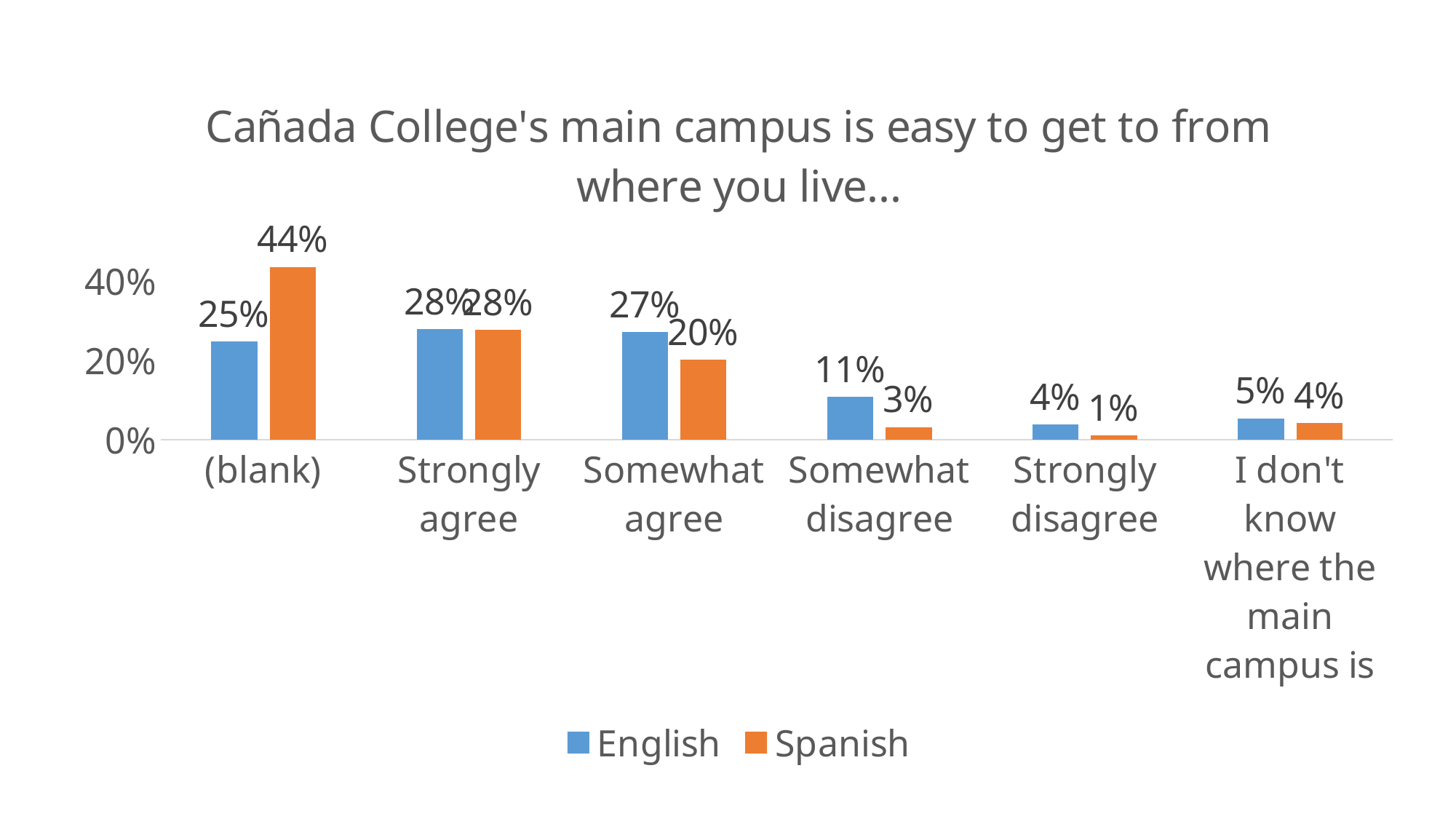
Which category has the highest Spanish value? (blank) What is the Spanish value for (blank)? 44% What is the English value for Strongly disagree? 4% What kind of chart is shown on the slide? Bar chart How many series does the legend list? 2 Which is larger for Somewhat agree, the English value or the Spanish value? English Which colour represents the Spanish series? Orange What is the difference between the Spanish and English values for (blank)? 19% What is the Spanish value for Somewhat disagree? 3% What is the English value for Somewhat agree? 27% Which category has the lowest Spanish value? Strongly disagree How many categories are shown on the x axis? 6